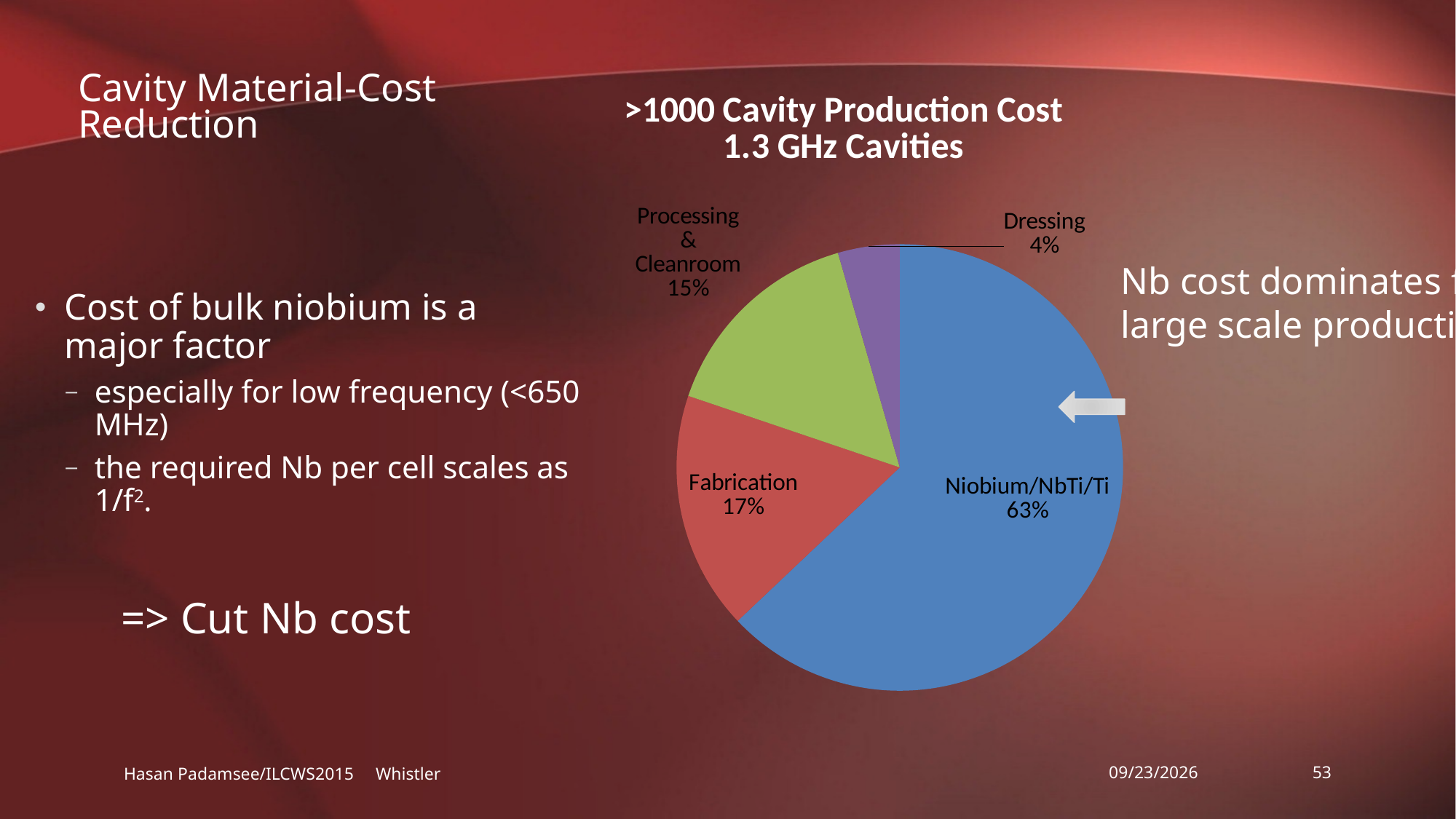
Which is larger, Fabrication or Processing & Cleanroom? Fabrication What percentage is shown for Dressing? 4% What is the title of the chart? >1000 Cavity Production Cost 1.3 GHz Cavities What share of the pie does Niobium/NbTi/Ti account for? 63% What percentage is shown for Fabrication? 17% What is the difference in percentage points between Niobium/NbTi/Ti and Fabrication? 46 What is the difference in percentage points between Fabrication and Processing & Cleanroom? 2 Which category has the largest slice of the pie? Niobium/NbTi/Ti How many categories are shown in the pie chart? 4 What percentage is shown for Processing & Cleanroom? 15% Which category has the smallest slice of the pie? Dressing What kind of chart is shown on the slide? Pie chart